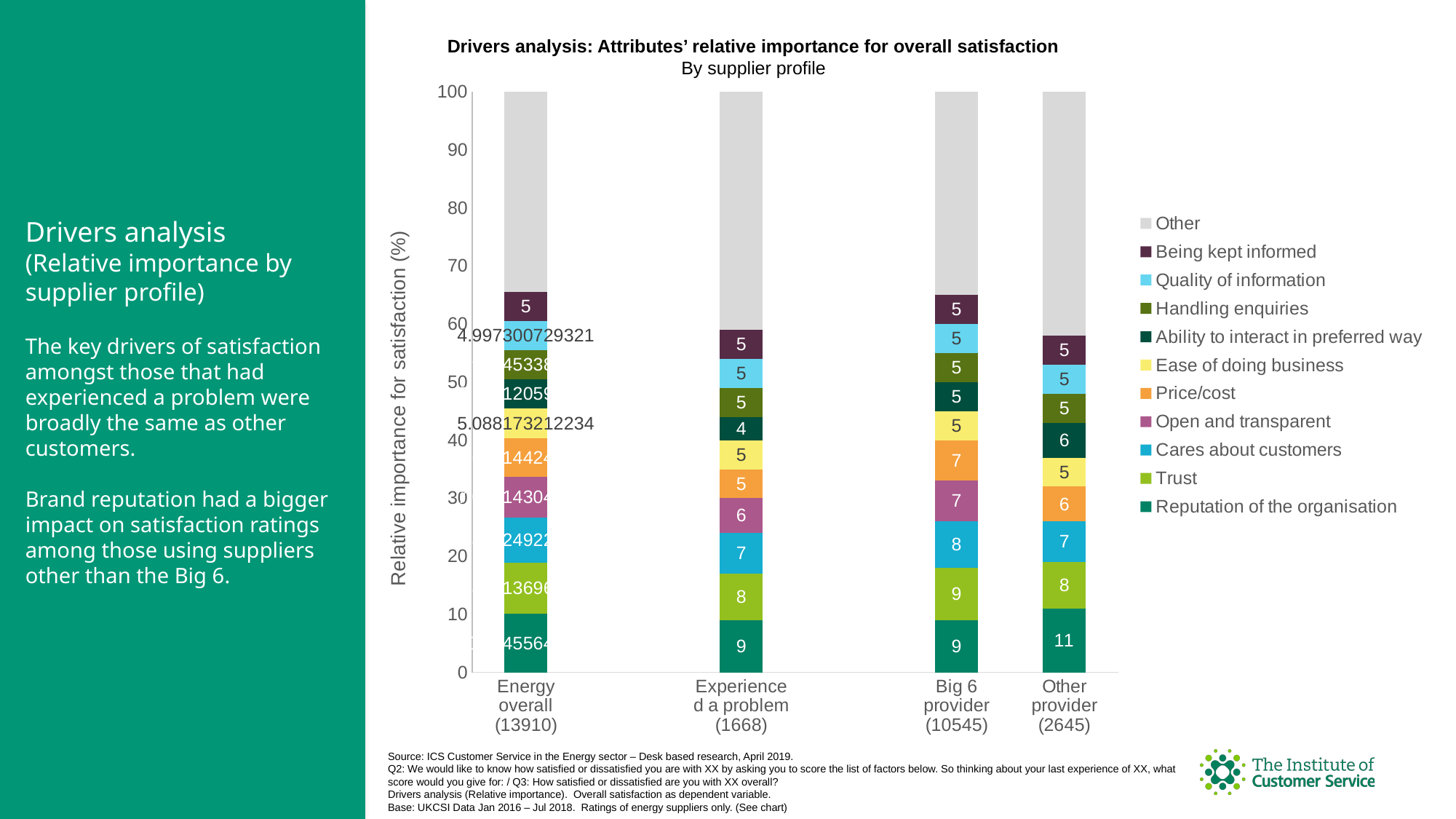
What kind of chart is shown on the slide? Stacked bar chart What is the value for Ability to interact in preferred way for Experienced a problem (1668)? 4 What is the value for Price/cost for Other provider (2645)? 6 How many supplier profile categories are shown on the x axis? 4 What is the value for Open and transparent for Experienced a problem (1668)? 6 What is the title of the y axis? Relative importance for satisfaction (%) What is the difference between the Price/cost value for Big 6 provider and for Experienced a problem? 2 What is the value for Reputation of the organisation for Other provider (2645)? 11 How many series does the legend list? 11 Which has the larger Cares about customers value, Big 6 provider or Other provider? Big 6 provider Which has the larger Reputation of the organisation value, Big 6 provider or Other provider? Other provider What is the value for Trust for Big 6 provider (10545)? 9